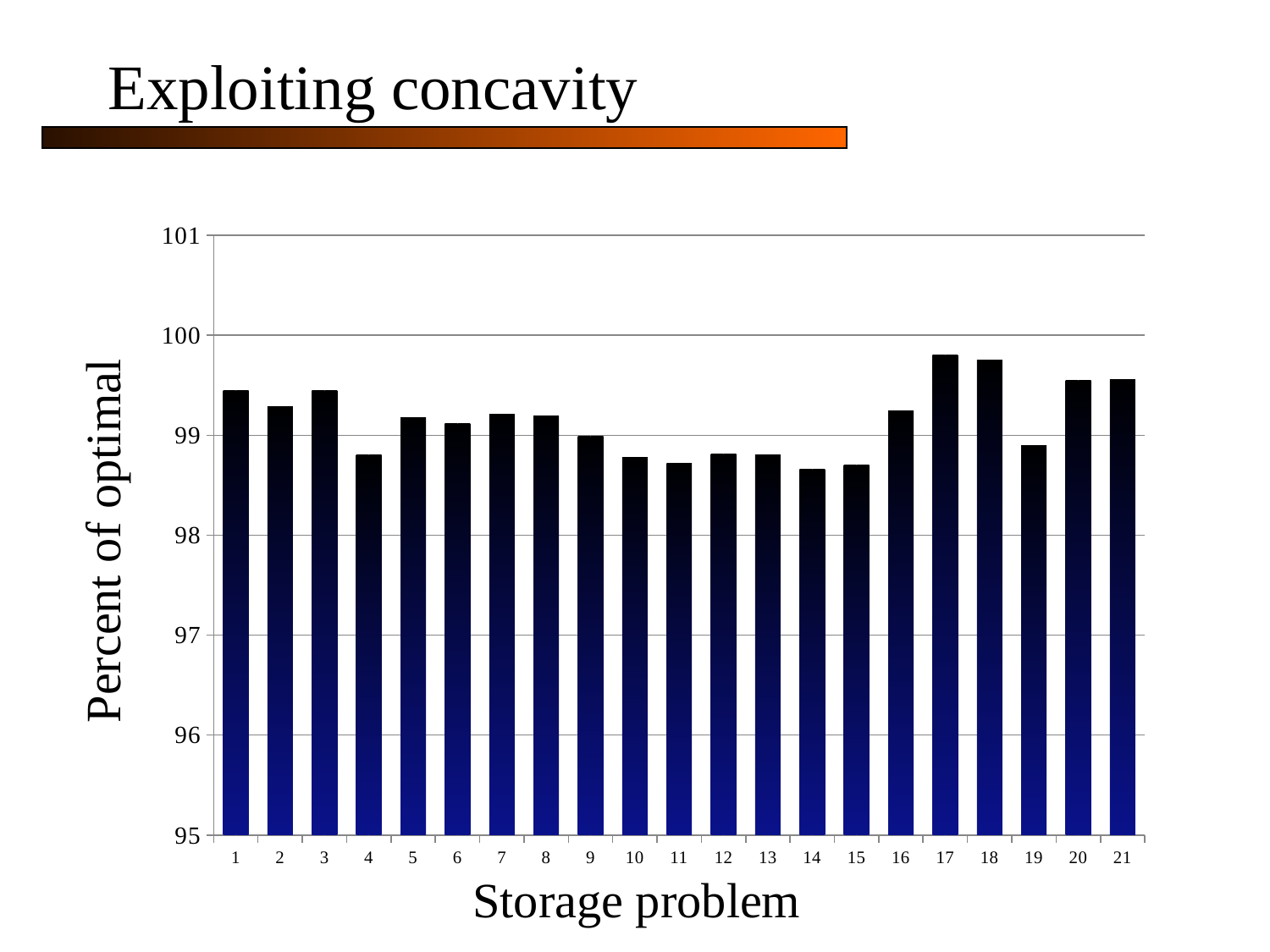
What is the label of the y axis? Percent of optimal What is the label of the x axis? Storage problem What kind of chart is shown on the slide? bar chart How many storage problems are plotted on the x axis? 21 Which storage problem has the highest percent of optimal? 17 Is the value for storage problem 17 greater or less than 99? greater Which has a higher percent of optimal, storage problem 17 or storage problem 4? 17 Is the value for storage problem 14 greater or less than 99? less Which has a higher percent of optimal, storage problem 20 or storage problem 19? 20 Is the value for storage problem 17 greater or less than 100? less